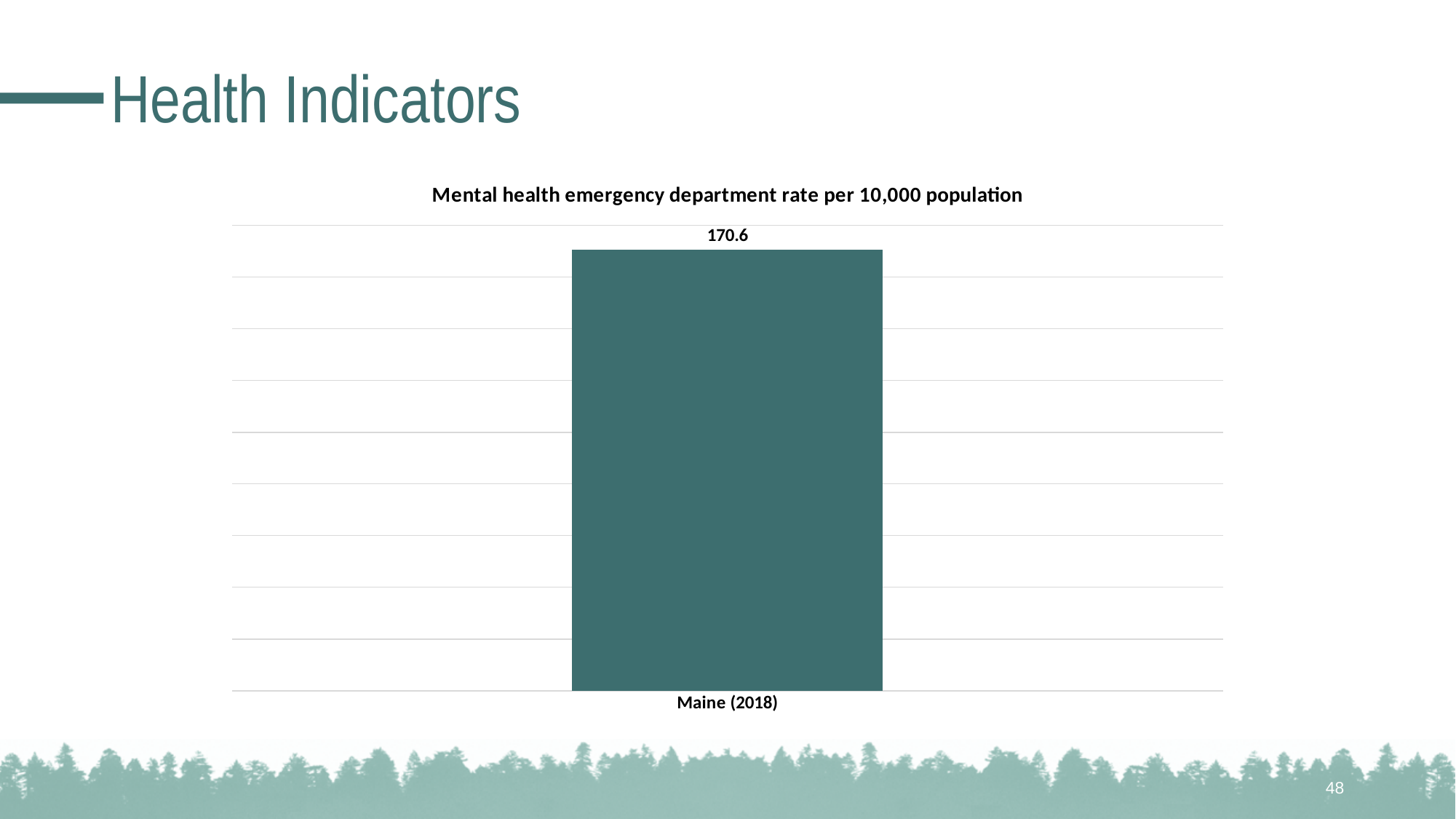
What is the mental health emergency department rate per 10,000 population for Maine (2018)? 170.6 Which category is labelled on the x axis of the chart? Maine (2018) Is the value for Maine (2018) greater or less than 100? greater What is the title of the chart? Mental health emergency department rate per 10,000 population How many bars are plotted in the chart? 1 What kind of chart is shown on the slide? bar chart